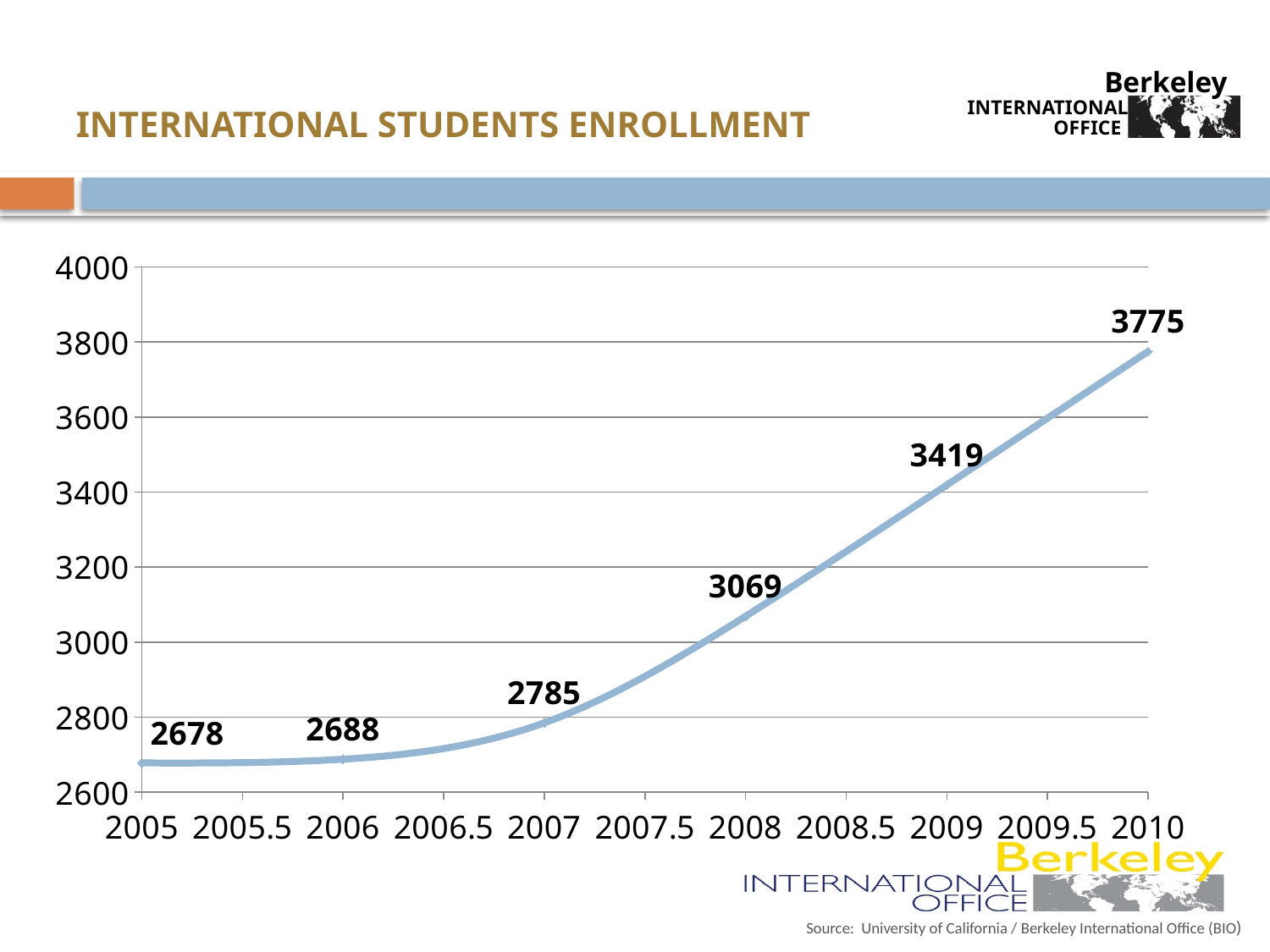
Do the enrollment values rise or fall from 2005 to 2010? Rise What is the difference between the enrollment in 2010 and the enrollment in 2009? 356 What was the international student enrollment in 2008? 3069 How many data points are labeled on the line? 6 What is the difference between the enrollment in 2007 and the enrollment in 2006? 97 What was the international student enrollment in 2010? 3775 Which year has the lowest enrollment value? 2005 Which is larger, the enrollment in 2008 or the enrollment in 2009? 2009 What was the international student enrollment in 2005? 2678 Which year has the highest enrollment value? 2010 Is the enrollment value for 2009 greater or less than 3400? greater What type of chart is shown on the slide? Line chart